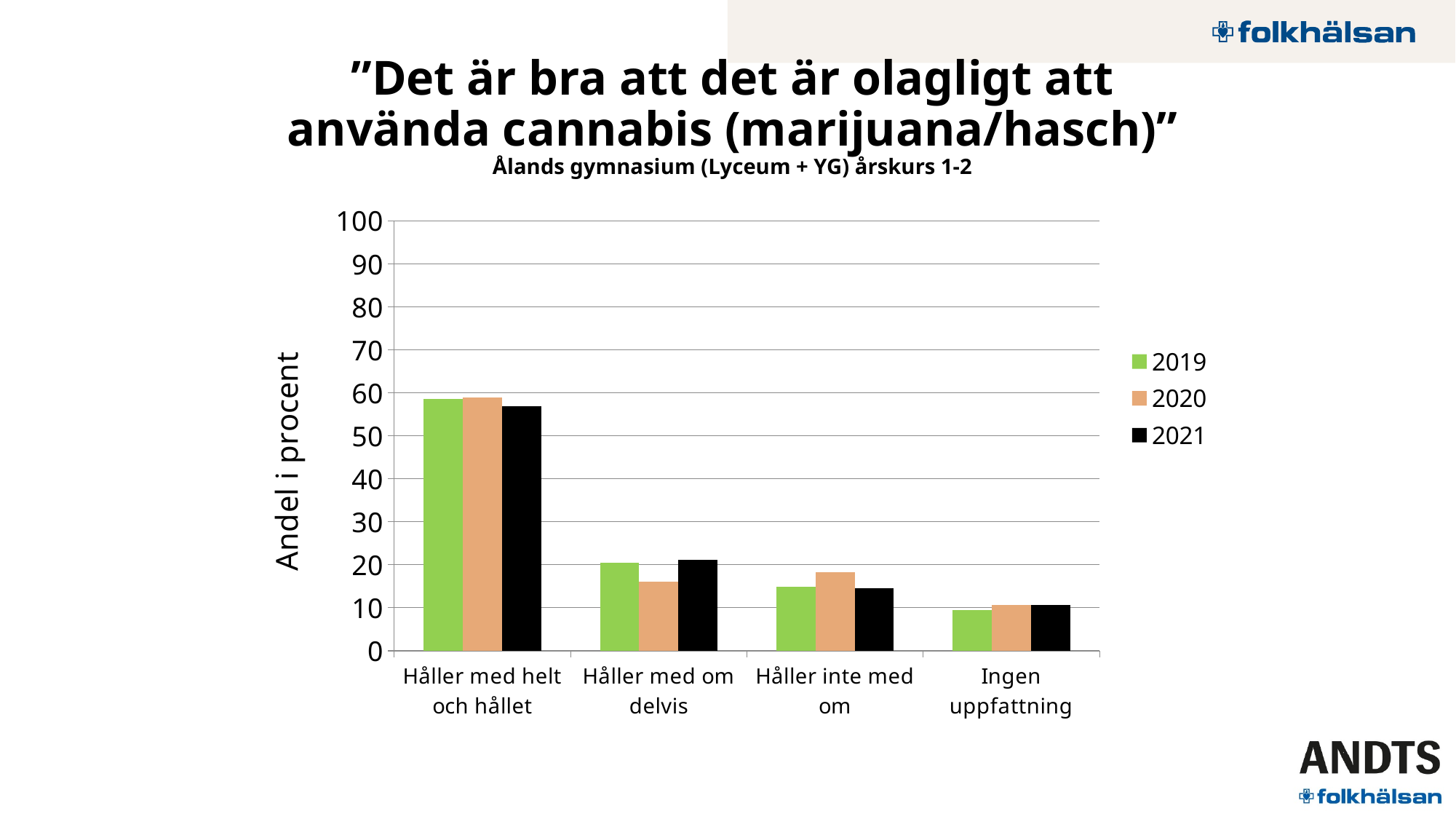
For Håller med om delvis, which year has the larger value, 2019 or 2020? 2019 Is the 2019 value for Håller med helt och hållet greater or less than 50? greater How many response categories are shown on the x axis? 4 Is the 2020 value for Håller med om delvis greater or less than 20? less What is the label on the y axis? Andel i procent Which category has the lowest value for 2019? Ingen uppfattning Is the 2020 value for Håller inte med om greater or less than 10? greater What kind of chart is shown on the slide? bar chart Which category has the highest value for 2021? Håller med helt och hållet For Håller inte med om, which year has the larger value, 2020 or 2021? 2020 How many series does the legend list? 3